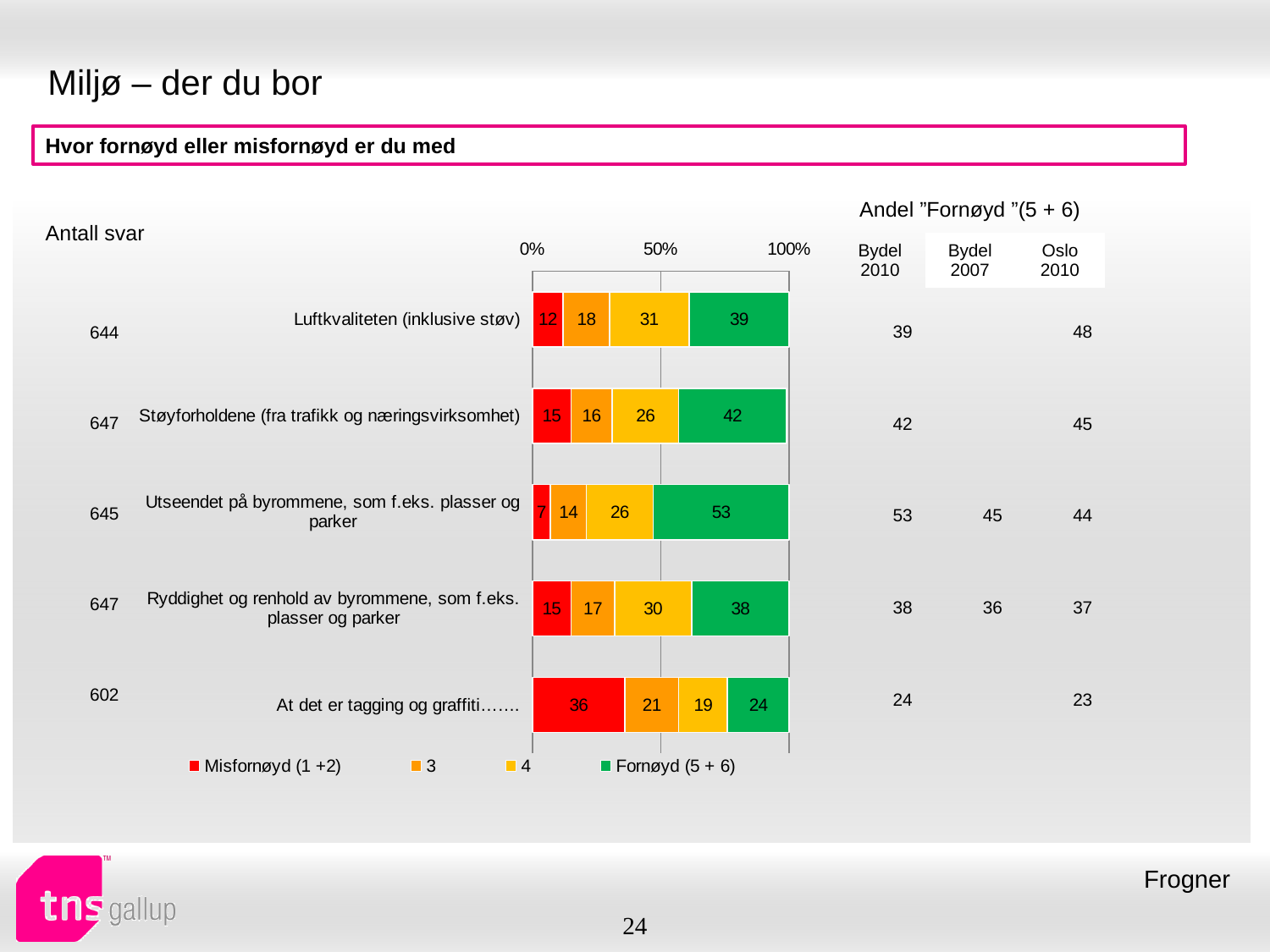
Which is larger: the "3" segment for "Luftkvaliteten (inklusive støv)" or the "3" segment for "Støyforholdene (fra trafikk og næringsvirksomhet)"? Luftkvaliteten (inklusive støv) Which category has the highest "Fornøyd (5 + 6)" value? Utseendet på byrommene, som f.eks. plasser og parker What colour represents the "Fornøyd (5 + 6)" series in the legend? Green Which category has the lowest "Misfornøyd (1 +2)" value? Utseendet på byrommene, som f.eks. plasser og parker How many categories are shown in the bar chart? 5 How many series does the legend list? 4 What is the value of the "4" segment for "Ryddighet og renhold av byrommene, som f.eks. plasser og parker"? 30 What is the value of the "Misfornøyd (1 +2)" segment for "At det er tagging og graffiti…"? 36 What kind of chart is shown on the slide? Stacked bar chart What is the value of the "Fornøyd (5 + 6)" segment for "Luftkvaliteten (inklusive støv)"? 39 What is the total of the stacked bar for "Støyforholdene (fra trafikk og næringsvirksomhet)"? 99 What is the difference between the "Fornøyd (5 + 6)" values for "Støyforholdene (fra trafikk og næringsvirksomhet)" and "Luftkvaliteten (inklusive støv)"? 3